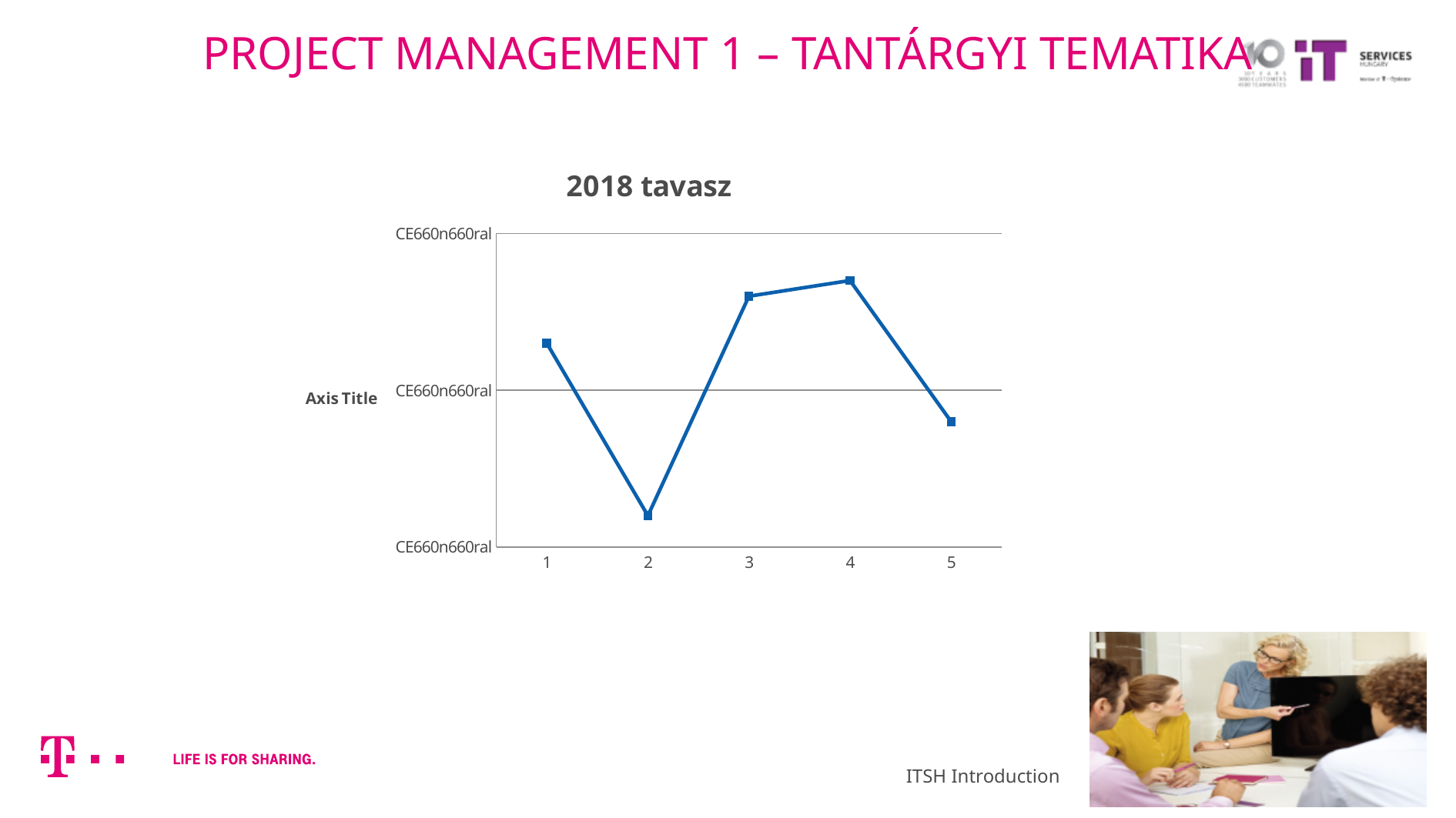
Which is larger, the value at category 3 or the value at category 5? 3 Which is larger, the value at category 1 or the value at category 5? 1 What is the title of the chart? 2018 tavasz Which is larger, the value at category 2 or the value at category 4? 4 Does the line rise or fall from category 2 to category 3? rise How many data points are plotted on the line? 5 Which x-axis category has the lowest value? 2 What text is shown as the vertical axis title? Axis Title Does the line rise or fall from category 4 to category 5? fall Does the line rise or fall from category 1 to category 2? fall What kind of chart is shown on the slide? line chart